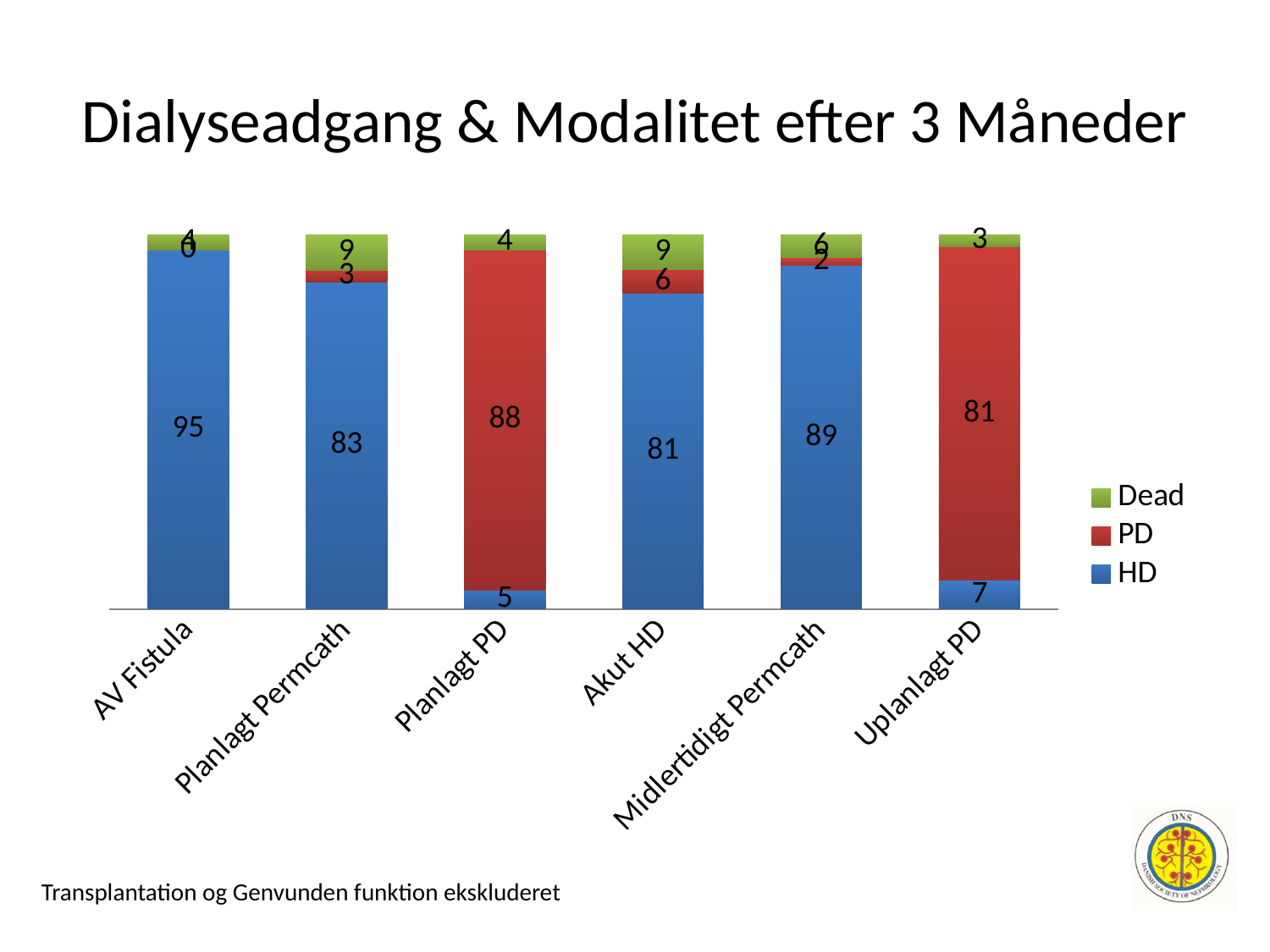
What is the PD value for Planlagt PD? 88 Which has the larger PD value, Planlagt PD or Uplanlagt PD? Planlagt PD Which category has the lowest HD value? Planlagt PD What is the Dead value for Akut HD? 9 How many categories are shown on the x axis? 6 How many series does the legend list? 3 What is the HD value for Uplanlagt PD? 7 What is the HD value for AV Fistula? 95 What is the total of the stacked bar for Akut HD? 96 What kind of chart is shown on the slide? Stacked bar chart Which category has the highest HD value? AV Fistula What is the difference between the HD values for Planlagt Permcath and Akut HD? 2